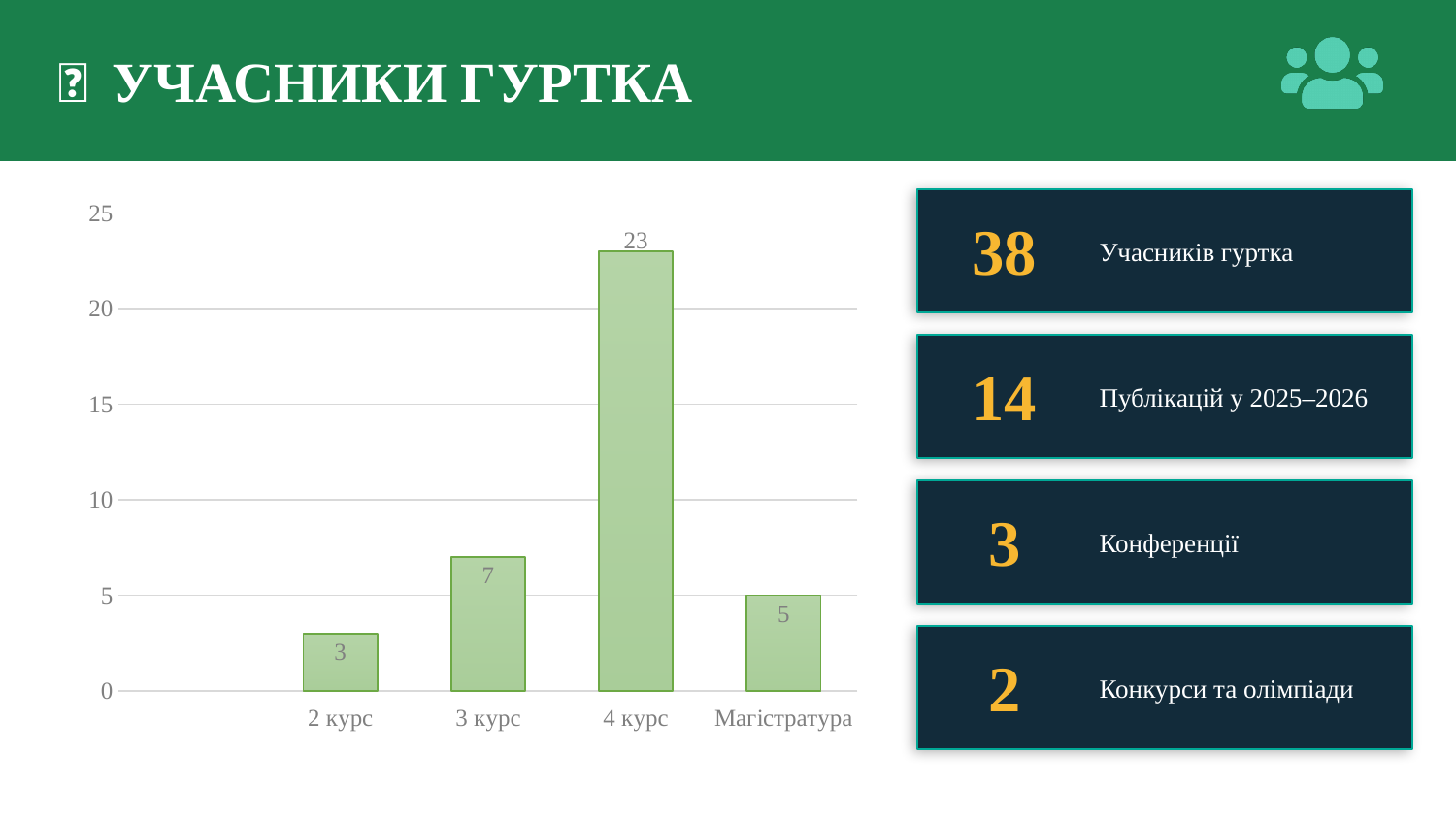
What is the value for 2 курс? 3 What is the highest value shown on the y axis? 25 Which category has the highest value? 4 курс Which is larger, the value for 3 курс or the value for Магістратура? 3 курс What is the difference between the values for 4 курс and 3 курс? 16 Which category has the lowest value? 2 курс What is the total of all four bar values? 38 What is the value for 4 курс? 23 What is the value for Магістратура? 5 Is the value for 4 курс greater or less than 20? greater What kind of chart is shown on the slide? bar chart How many categories are shown on the x axis? 4